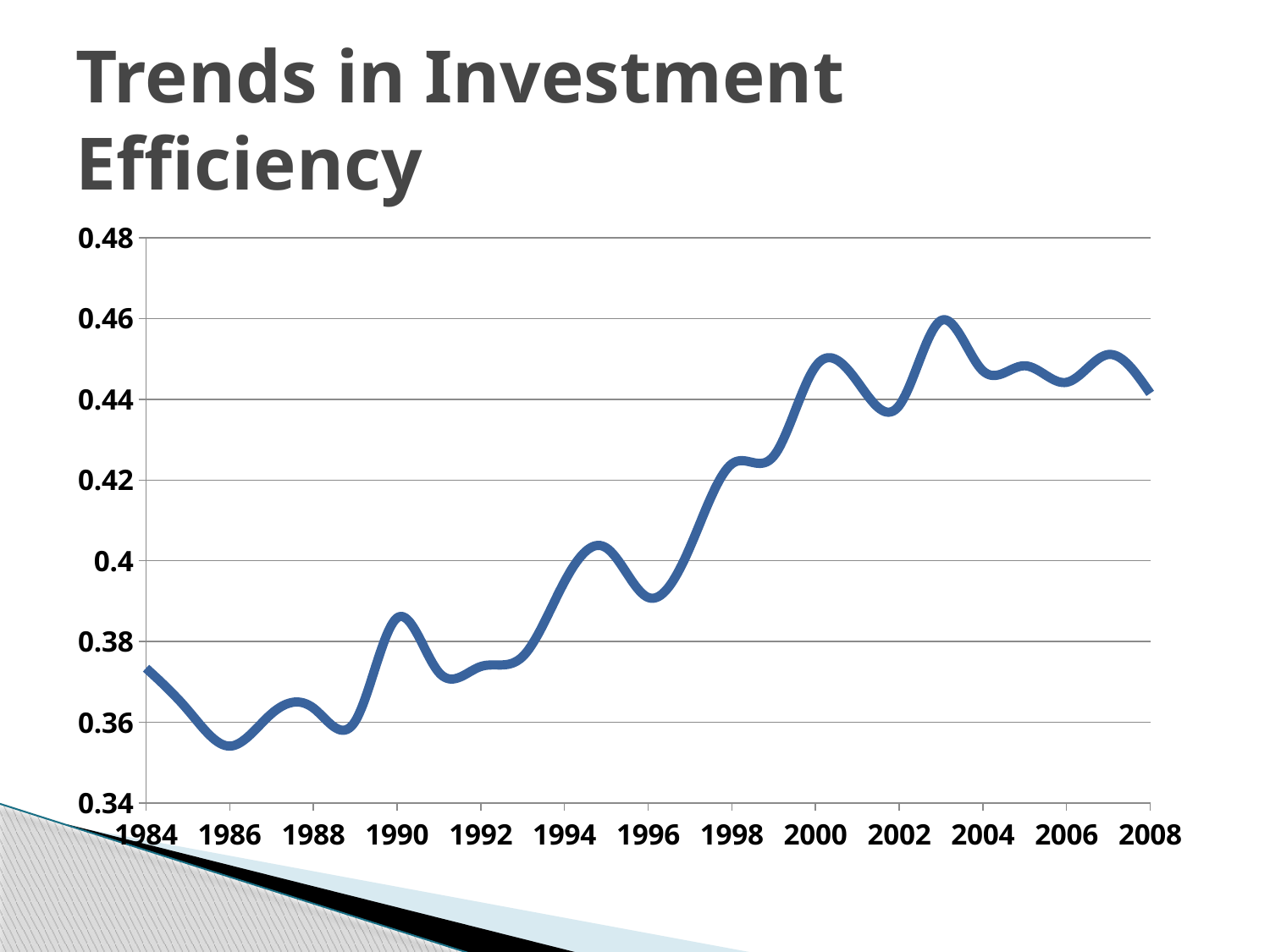
Which is larger, the value for 1984 or the value for 2000? 2000 Which year has the highest value on the chart? 2003 What kind of chart is shown on the slide? line chart What is the title of the slide's chart? Trends in Investment Efficiency Is the value for 1984 greater or less than 0.36? greater Which year has the lowest value on the chart? 1986 Is the value for 1986 greater or less than 0.36? less Is the value for 1992 greater or less than 0.38? less Overall, do the values rise or fall from 1984 to 2008? rise